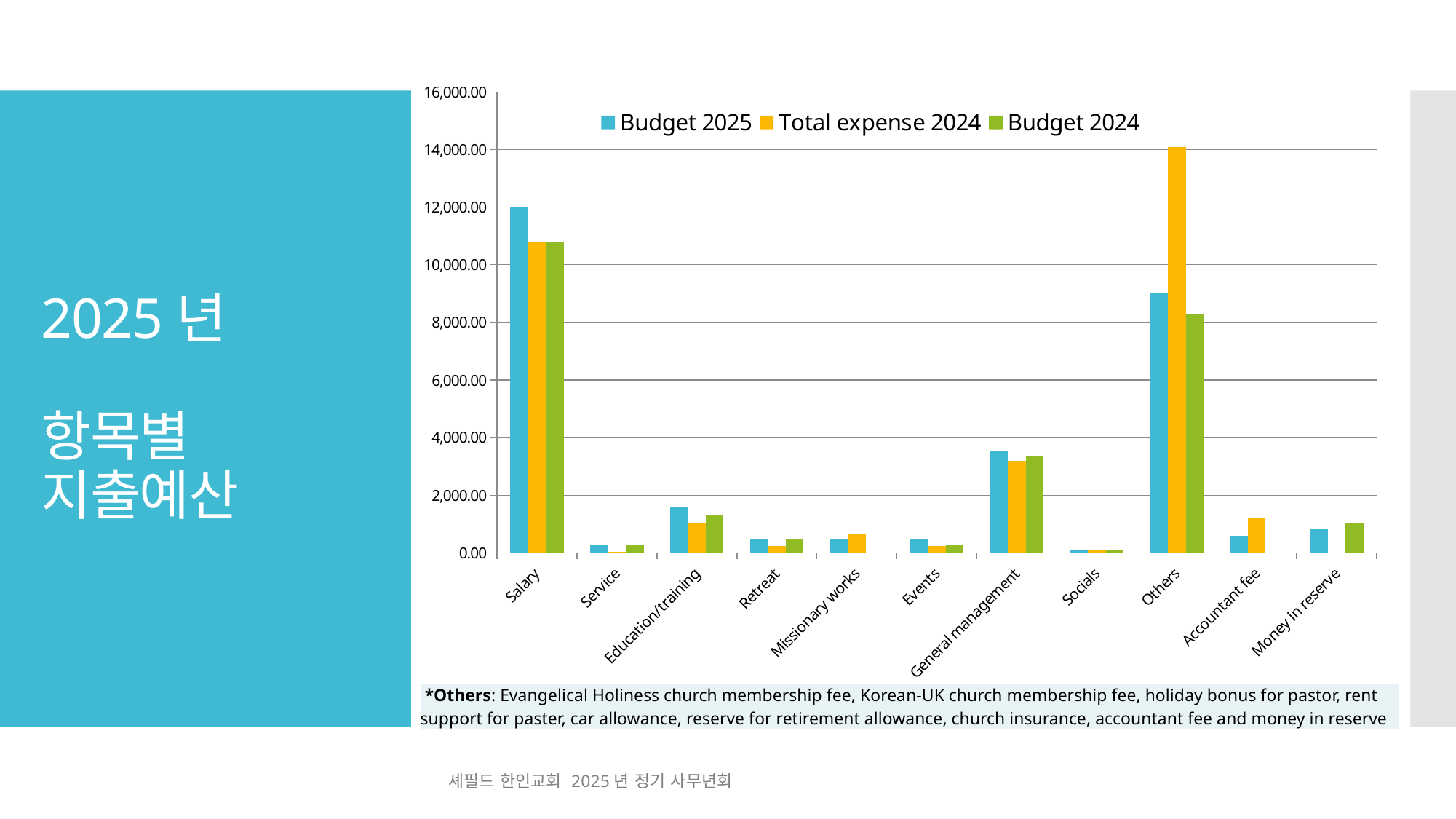
Which category has the highest Budget 2025 value? Salary What are the three series listed in the legend? Budget 2025, Total expense 2024, Budget 2024 Is the Budget 2025 value for General management greater or less than 4,000.00? less For Salary, which is larger: Budget 2025 or Total expense 2024? Budget 2025 Is the Total expense 2024 value for Others greater or less than 12,000.00? greater Is the Budget 2025 value for Salary greater or less than 10,000.00? greater How many categories are shown on the x axis? 11 For Others, which is larger: Total expense 2024 or Budget 2024? Total expense 2024 Which category has the highest Total expense 2024 value? Others Which category has the lowest Budget 2025 value? Socials What kind of chart is shown on the slide? bar chart How many series does the legend list? 3